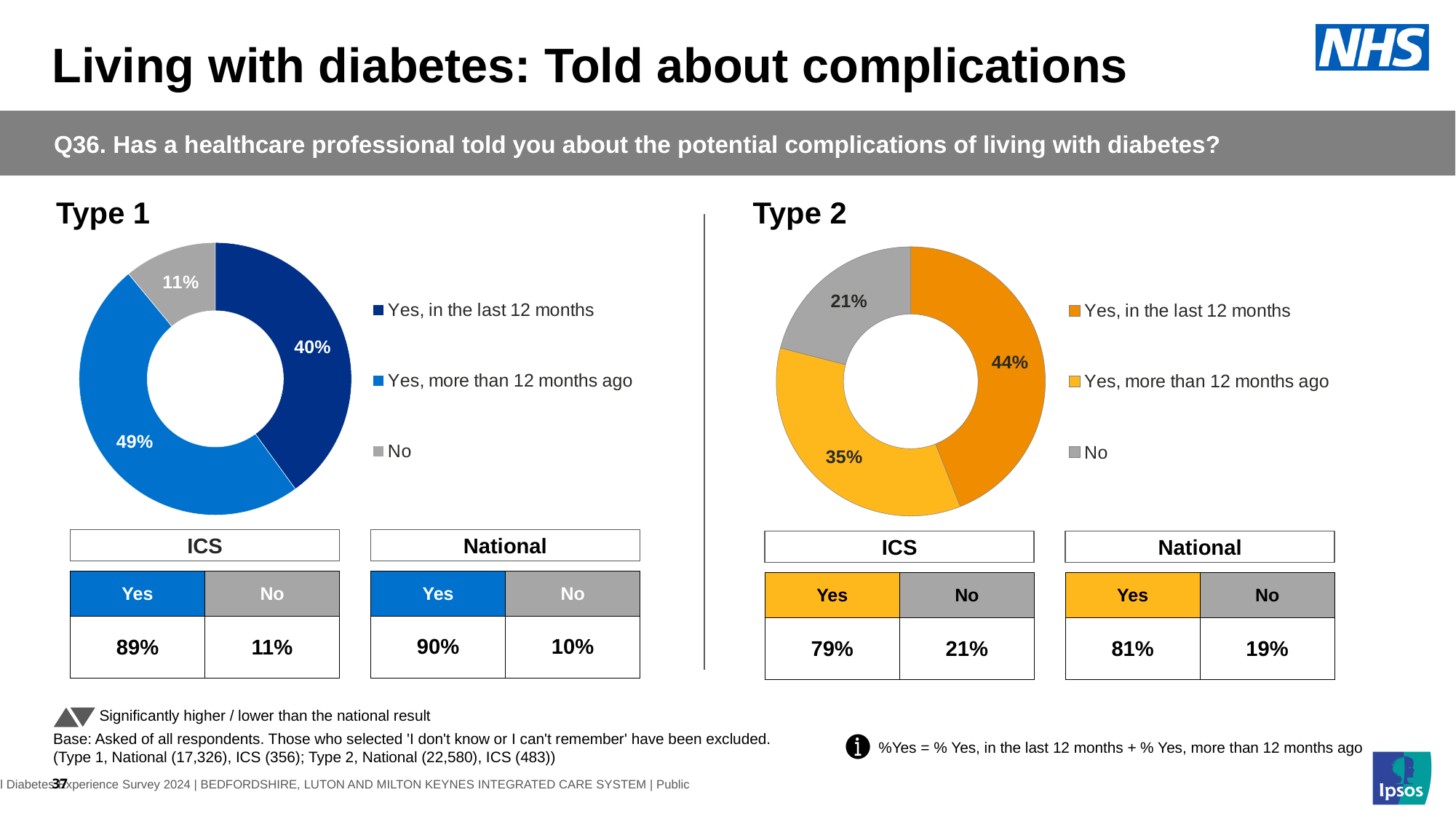
In the Type 1 chart, which is larger: 'Yes, in the last 12 months' or 'No'? Yes, in the last 12 months How many legend entries does the Type 1 chart list? 3 What kind of chart is used for Type 1? Doughnut chart In the Type 1 chart, what percentage of respondents said 'Yes, in the last 12 months'? 40% In the Type 2 chart, what share of the doughnut is 'Yes, more than 12 months ago'? 35% In the Type 1 chart, which category has the largest share? Yes, more than 12 months ago In the Type 2 chart, which category has the smallest share? No In the Type 2 chart, what percentage of respondents said 'No'? 21% What colour represents 'No' in the Type 2 chart? Grey How many categories does the Type 2 chart show? 3 In the Type 1 chart, what is the combined share of the two 'Yes' categories? 89% In the Type 2 chart, what is the difference between 'Yes, in the last 12 months' and 'Yes, more than 12 months ago'? 9 percentage points